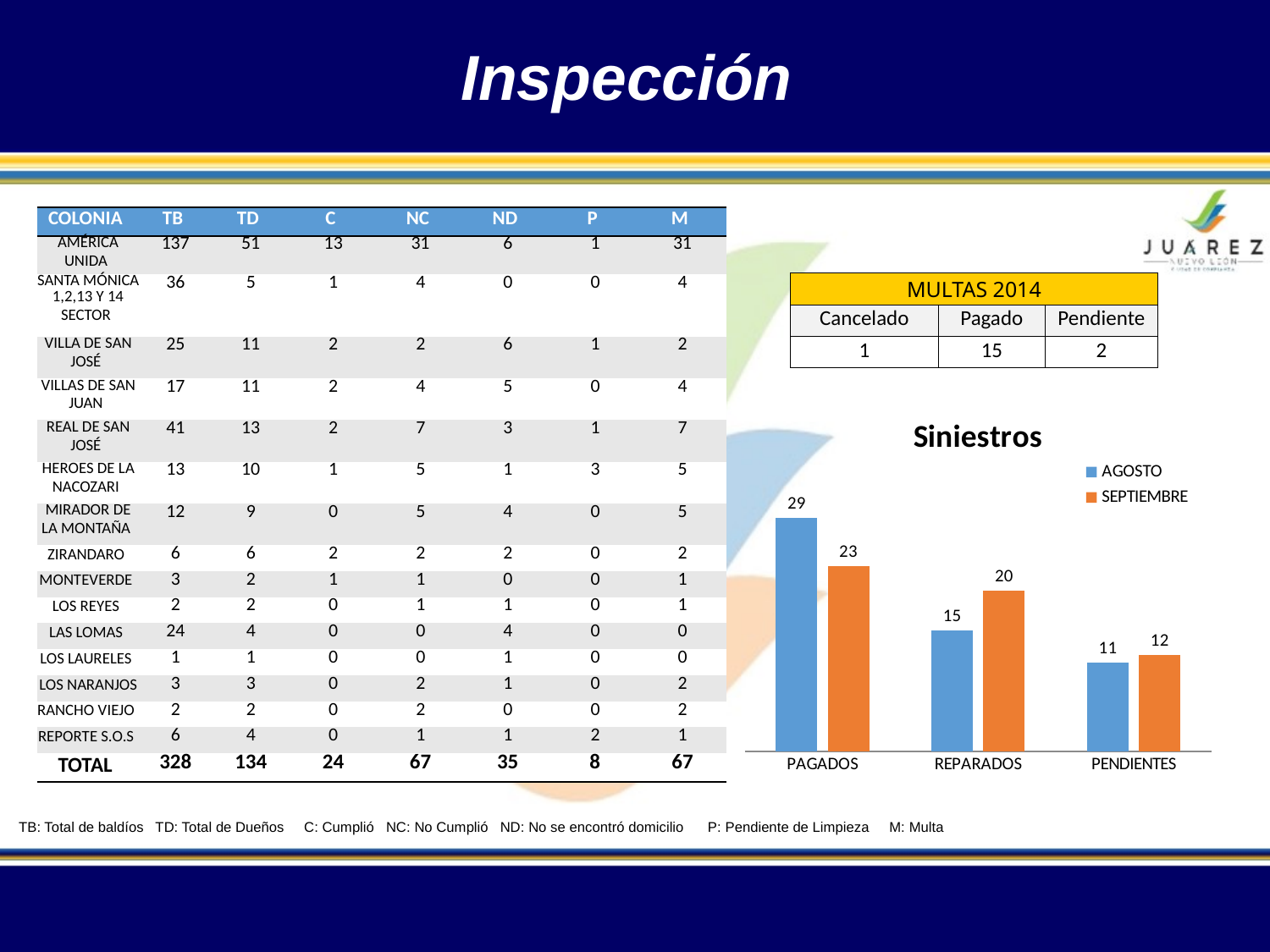
In the Siniestros chart, which category has the highest AGOSTO value? PAGADOS How many categories are shown on the x axis of the Siniestros chart? 3 In the Siniestros chart, what is the SEPTIEMBRE value for REPARADOS? 20 In the Siniestros chart, which colour represents the SEPTIEMBRE series? Orange In the Siniestros chart, which is larger for REPARADOS: AGOSTO or SEPTIEMBRE? SEPTIEMBRE In the Siniestros chart, what is the AGOSTO value for PAGADOS? 29 How many series does the legend of the Siniestros chart list? 2 In the Siniestros chart, what is the SEPTIEMBRE value for PENDIENTES? 12 In the Siniestros chart, what is the difference between the AGOSTO and SEPTIEMBRE values for PAGADOS? 6 In the Siniestros chart, which category has the lowest SEPTIEMBRE value? PENDIENTES What kind of chart is the Siniestros chart? Bar chart In the Siniestros chart, what is the difference between the SEPTIEMBRE and AGOSTO values for REPARADOS? 5